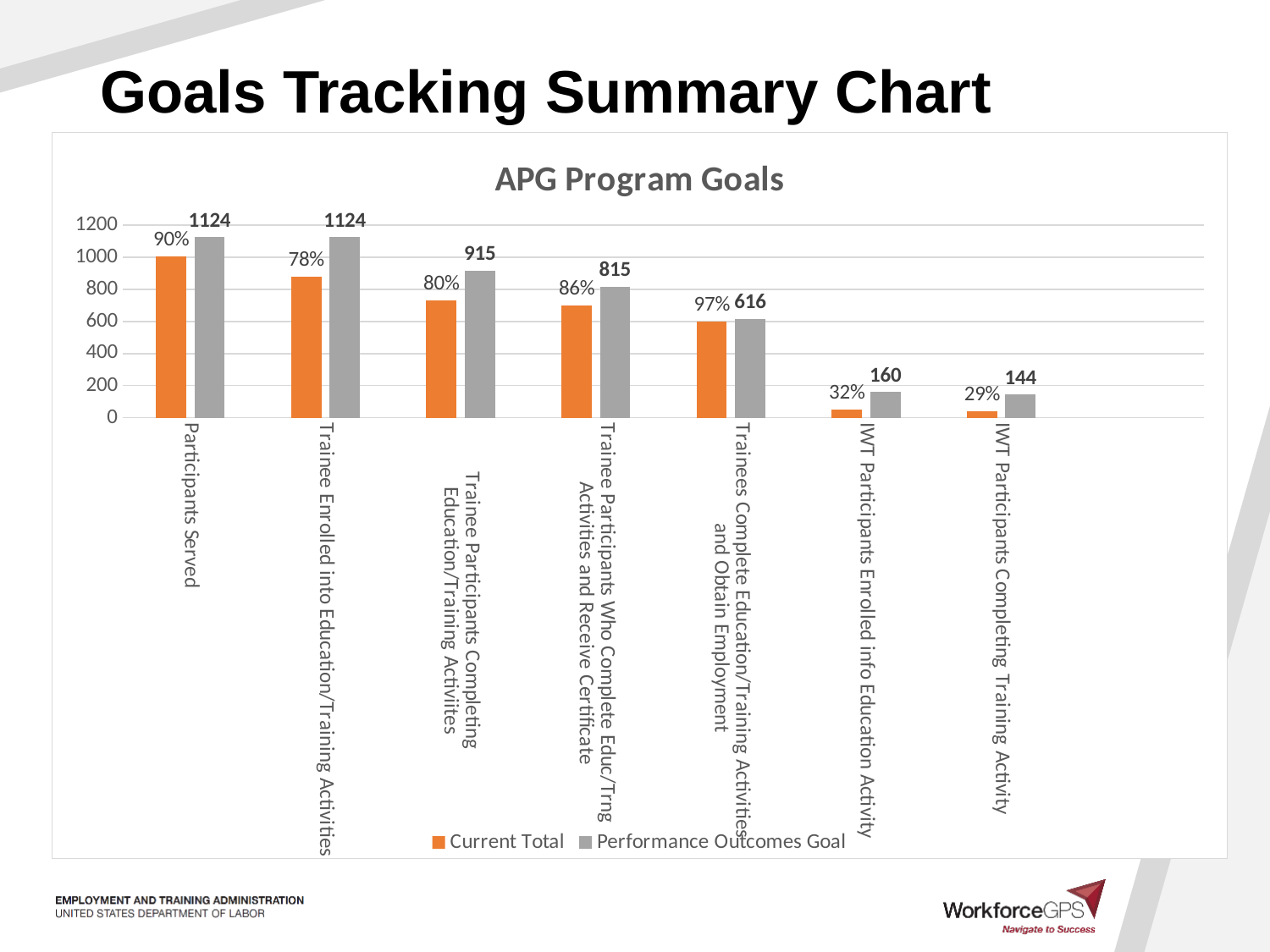
How many series does the legend list? 2 How many categories are shown on the x axis? 7 Which is larger, the Performance Outcomes Goal for IWT Participants Enrolled into Education Activity or for IWT Participants Completing Training Activity? IWT Participants Enrolled into Education Activity What is the Performance Outcomes Goal for Trainee Participants Completing Education/Training Activities? 915 Which category has the lowest Performance Outcomes Goal? IWT Participants Completing Training Activity What percentage label is shown on the Current Total bar for Trainees Complete Education/Training Activities and Obtain Employment? 97% What is the Performance Outcomes Goal for IWT Participants Completing Training Activity? 144 What type of chart is shown on the slide? bar chart Is the Current Total for Participants Served greater or less than 800? greater What is the title of the chart? APG Program Goals What is the difference between the Performance Outcomes Goal for Trainee Participants Completing Education/Training Activities and for Trainee Participants Who Complete Educ/Trng Activities and Receive Certificate? 100 What is the Performance Outcomes Goal for Participants Served? 1124